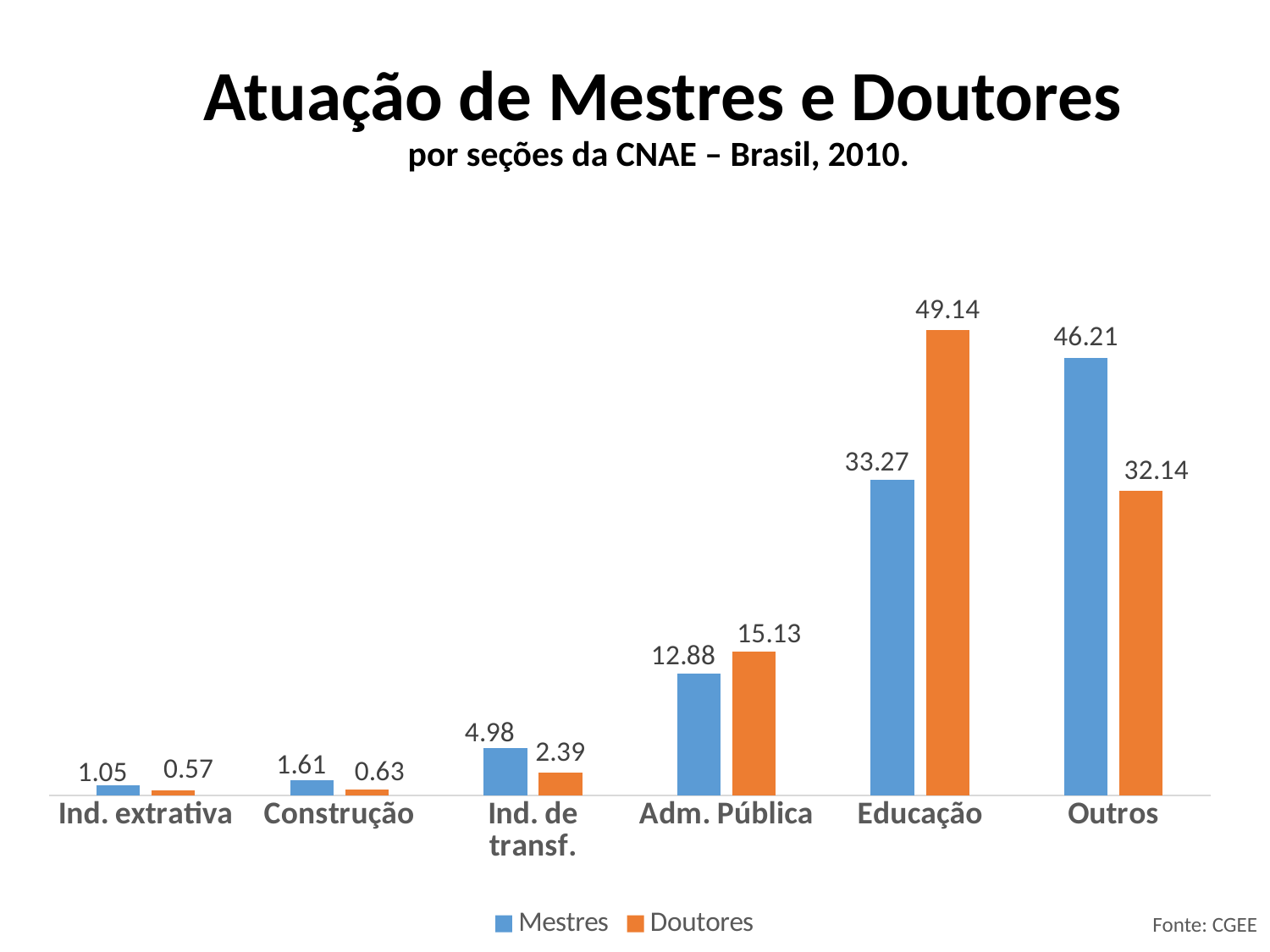
Which is larger for Ind. de transf., the Mestres value or the Doutores value? Mestres How many categories are shown on the x axis? 6 What is the Doutores value for Construção? 0.63 What is the Doutores value for Adm. Pública? 15.13 Which category has the lowest Mestres value? Ind. extrativa What is the difference between the Doutores and Mestres values for Educação? 15.87 What kind of chart is shown on the slide? Bar chart Which category has the highest Doutores value? Educação What is the difference between the Mestres and Doutores values for Outros? 14.07 How many series does the legend list? 2 What is the Mestres value for Educação? 33.27 Which colour represents the Doutores series? Orange